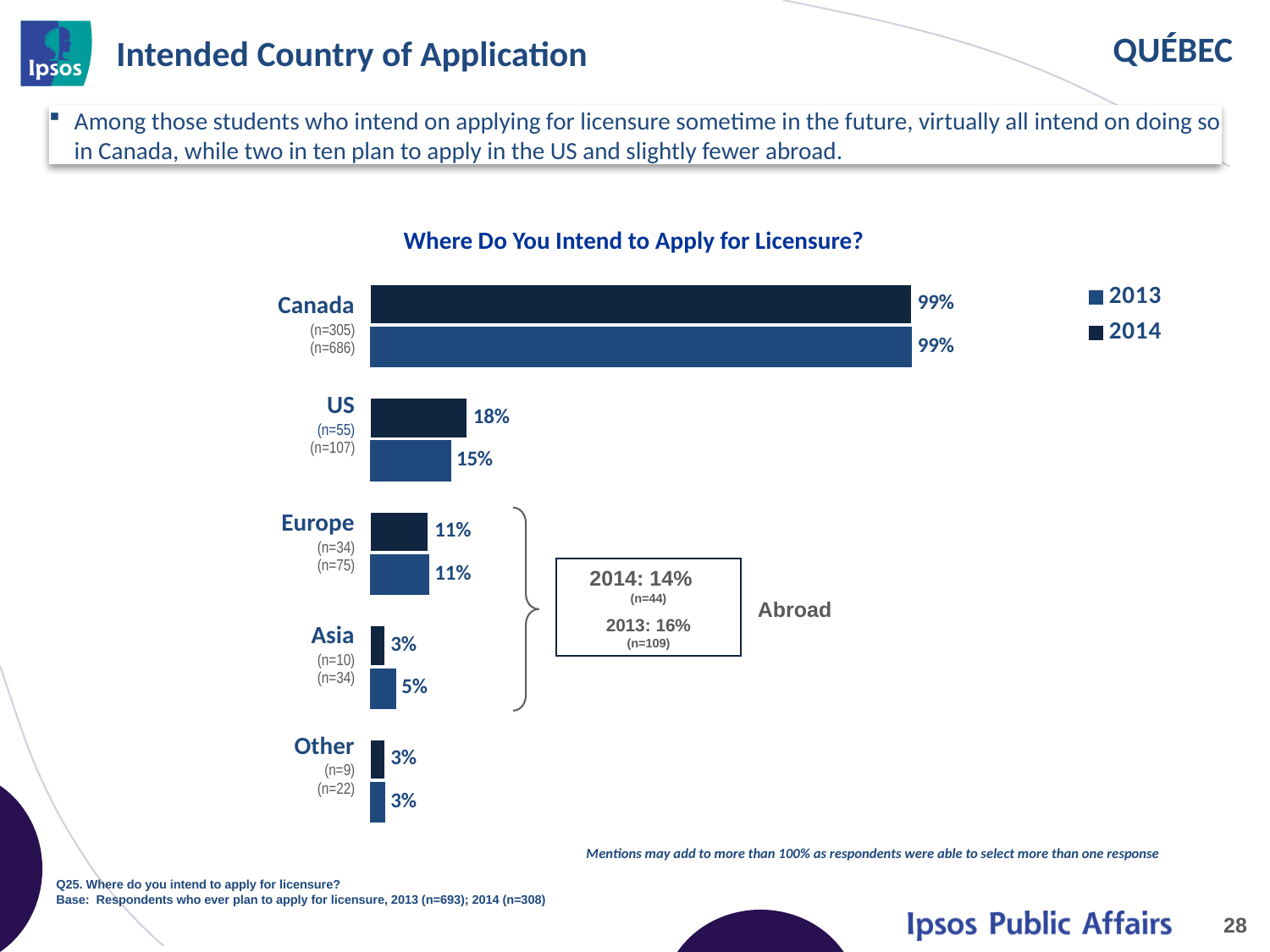
What is the title of the chart? Where Do You Intend to Apply for Licensure? What are the two series listed in the legend? 2013 and 2014 What is the value for Europe in 2013? 11% What type of chart is shown on the slide? bar chart What is the difference between the 2013 and 2014 values for US? 3 percentage points How many series does the legend list? 2 Which category has the highest value in the chart? Canada What is the value for US in 2013? 15% What is the value for Asia in 2014? 3% How many countries/regions are shown as categories in the chart? 5 Which is larger: the 2013 value for US or the 2013 value for Europe? US (15%) What is the value for Canada in 2014? 99%